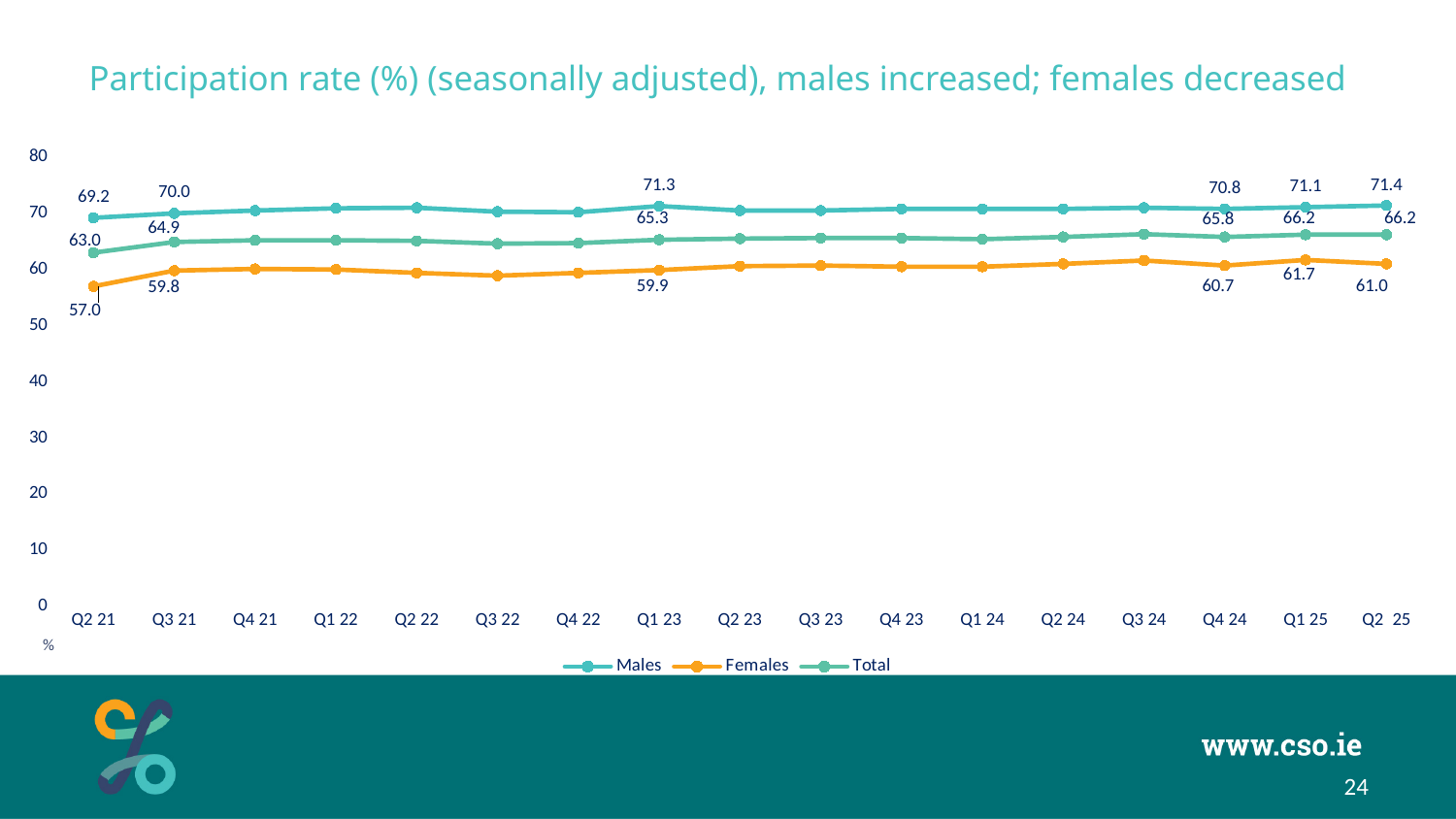
What is the Females participation rate in Q2 21? 57.0 By how much did the Males participation rate change from Q1 25 to Q2 25? 0.3 Does the Males participation rate rise or fall from Q2 21 to Q2 25? rise What is the Males participation rate in Q2 25? 71.4 In Q2 25, which is higher: the Males rate or the Females rate? Males What kind of chart is shown on the slide? line chart How many series does the legend list? 3 How many quarters are shown on the x axis? 17 In which quarter is the Females participation rate lowest? Q2 21 What is the Total participation rate in Q1 23? 65.3 By how much did the Females participation rate fall from Q1 25 to Q2 25? 0.7